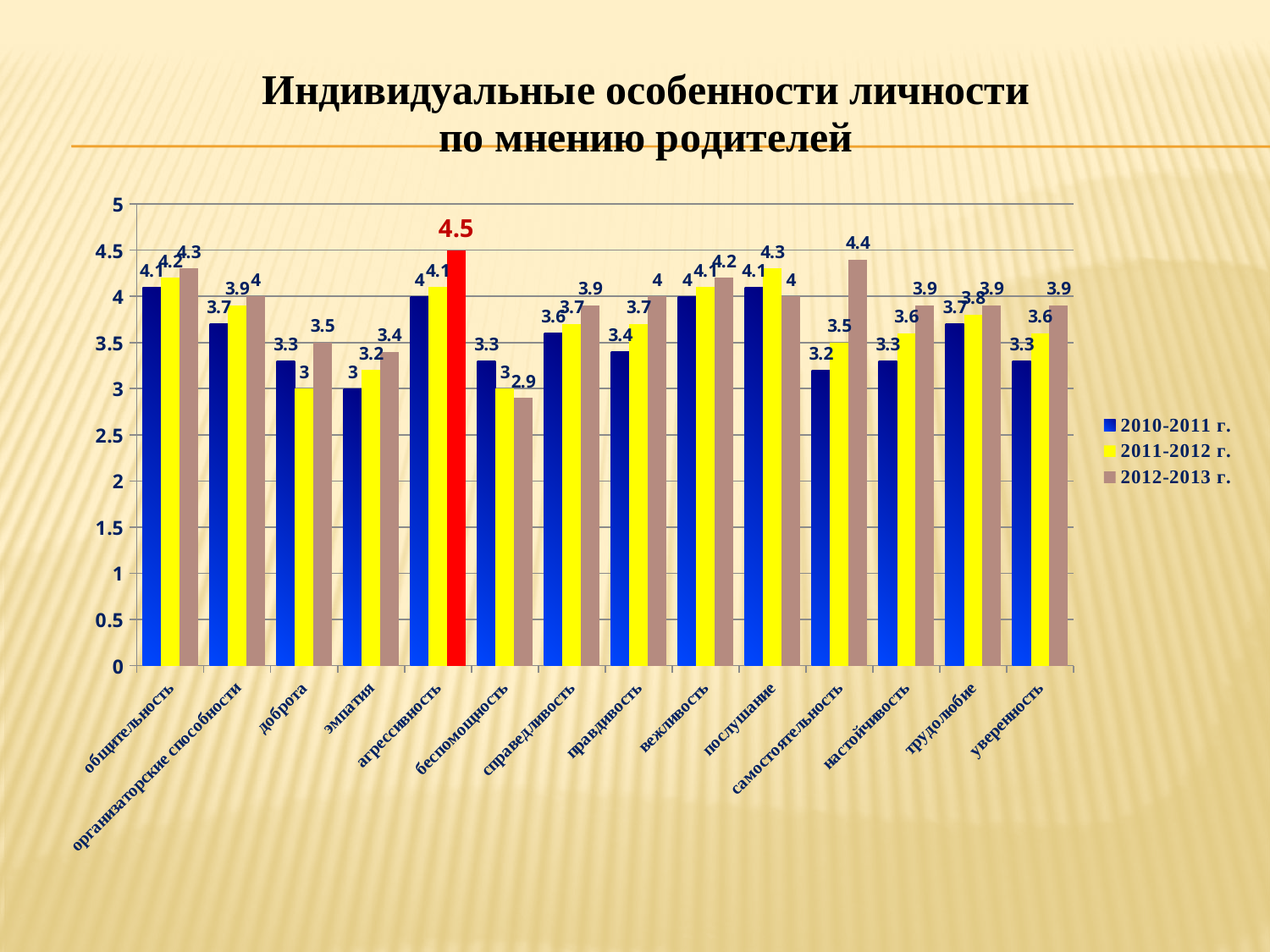
What kind of chart is shown on the slide? bar chart Which bar on the chart is coloured red? агрессивность, 2012-2013 г. Which category has the lowest value in the 2012-2013 г. series? беспомощность What is the value for беспомощность in the 2012-2013 г. series? 2.9 What is the value for агрессивность in the 2012-2013 г. series? 4.5 Do the values for настойчивость rise or fall from 2010-2011 г. to 2012-2013 г.? rise Which is larger for послушание: the 2011-2012 г. value or the 2012-2013 г. value? 2011-2012 г. How many categories are shown on the x axis? 14 How many series does the legend list? 3 What is the value for самостоятельность in the 2010-2011 г. series? 3.2 What is the difference between the 2012-2013 г. and 2010-2011 г. values for самостоятельность? 1.2 Which category has the highest value in the 2012-2013 г. series? агрессивность